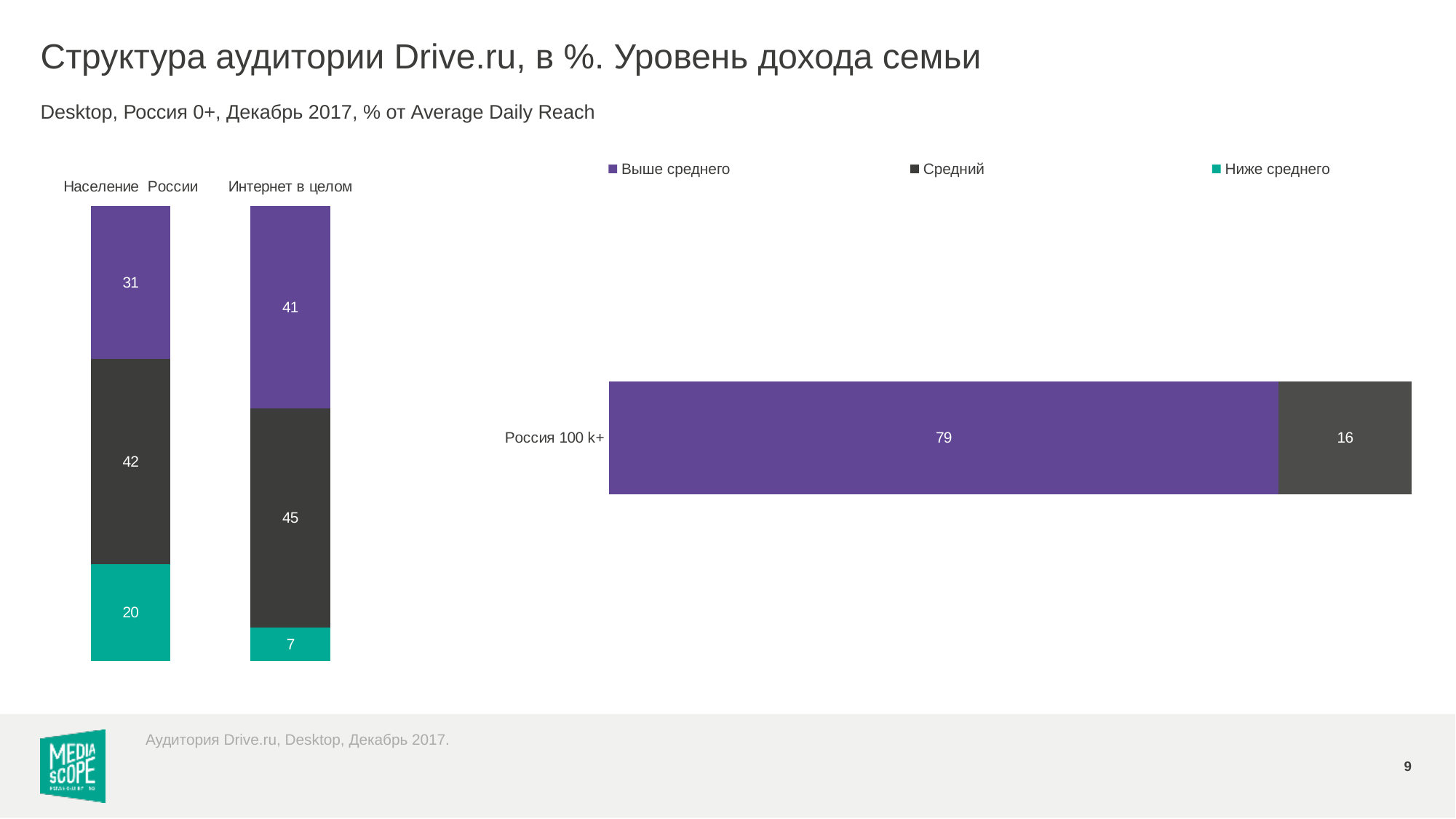
In the left chart, what is the value of the 'Выше среднего' segment for 'Население России'? 31 In the right chart, what is the value of the 'Выше среднего' segment for 'Россия 100 k+'? 79 In the left chart, which segment is the largest in the 'Население России' bar? Средний In the left chart, what is the value of the 'Ниже среднего' segment for 'Интернет в целом'? 7 Which colour represents 'Ниже среднего' in the legend? Teal (green) What kind of chart is shown on the right side of the slide? Stacked bar chart How many series does the legend list? 3 In the left chart, which has a larger 'Выше среднего' value: 'Население России' or 'Интернет в целом'? Интернет в целом In the left chart, which segment is the smallest in the 'Интернет в целом' bar? Ниже среднего In the left chart, what is the difference between the 'Ниже среднего' values for 'Население России' and 'Интернет в целом'? 13 In the left chart, what is the value of the 'Средний' segment for 'Интернет в целом'? 45 In the right chart, what is the value of the 'Средний' segment for 'Россия 100 k+'? 16